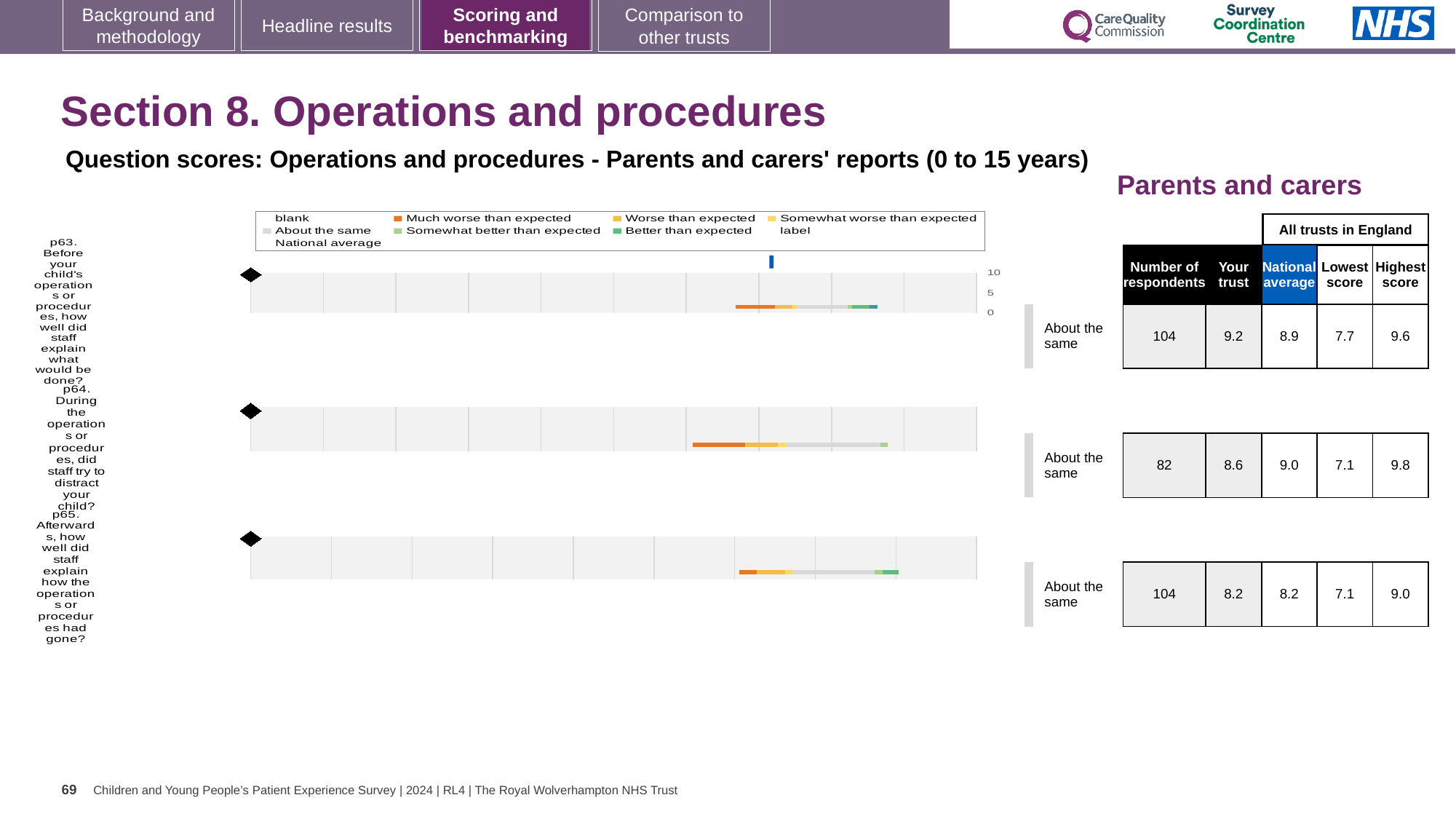
For question p64, what is the difference between the national average and the 'Your trust' score? 0.4 What benchmark category label is shown next to each of the three charts? About the same How many questions are plotted on this slide? 3 What is the lowest score among all trusts in England for question p63? 7.7 What kind of chart is used to show the question scores on this slide? Bar chart For question p63, which is larger: the 'Your trust' score or the national average? Your trust What is the 'Your trust' score for question p63 (how well staff explained what would be done before the operation)? 9.2 Which question has the highest 'Your trust' score on this slide? p63 How many respondents answered question p65 (how well staff explained how the operation had gone)? 104 Which question has the lowest 'Your trust' score on this slide? p65 What is the national average score for question p64 (did staff try to distract your child during the operation)? 9.0 What is the highest score among all trusts in England for question p64? 9.8